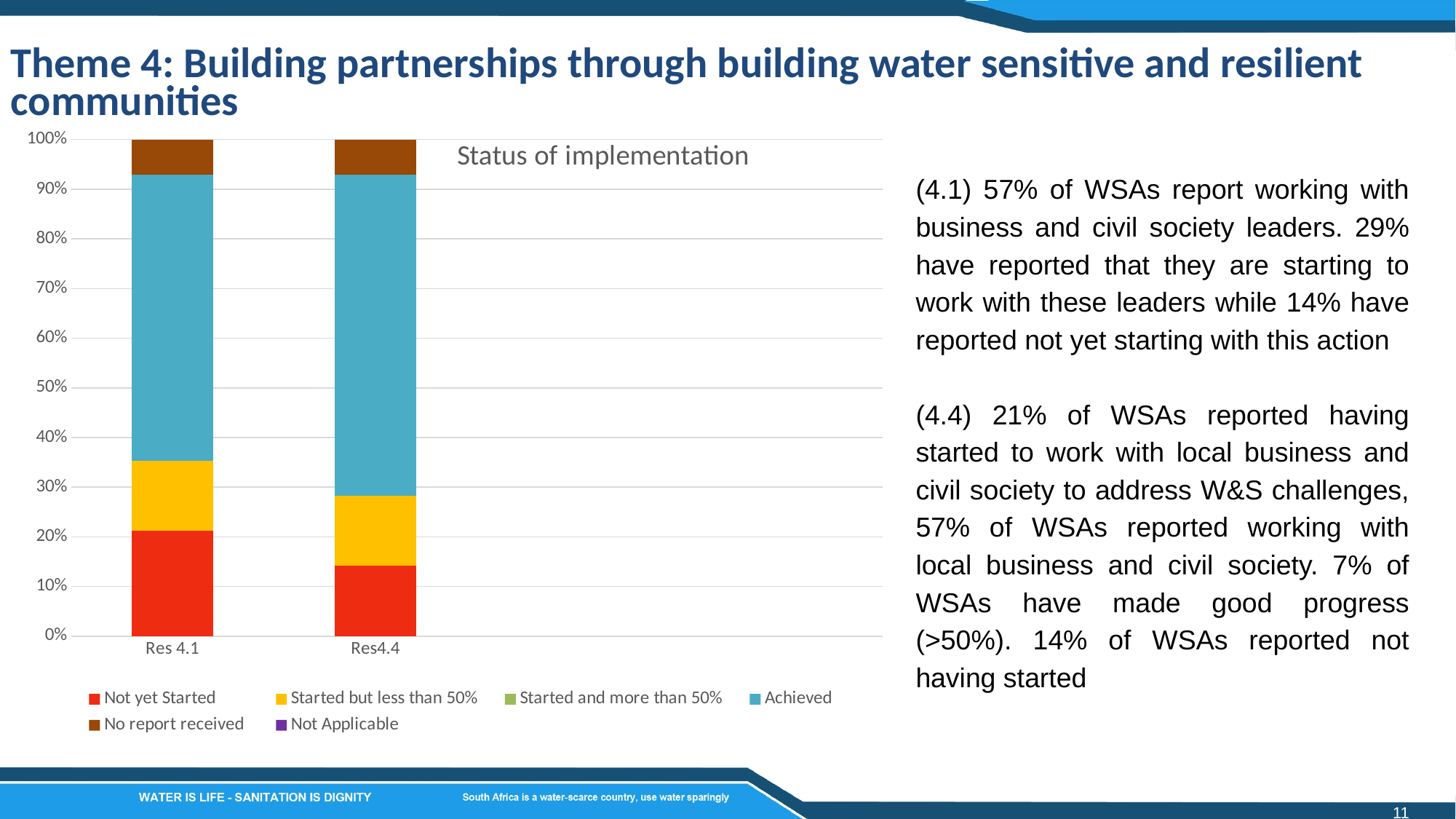
What colour represents the 'Achieved' series in the chart? Blue What kind of chart is shown on the slide? Stacked bar chart What is the title of the chart? Status of implementation Is the 'Not yet Started' value for Res 4.1 greater or less than 30%? less Is the top of the 'Achieved' segment for Res4.4 greater or less than 80%? greater Is the 'Not yet Started' value for Res4.4 greater or less than 20%? less How many series does the chart legend list? 6 Which category has the larger 'Not yet Started' segment, Res 4.1 or Res4.4? Res 4.1 How many categories are plotted on the x axis of the chart? 2 Which category has the larger 'Achieved' segment, Res 4.1 or Res4.4? Res4.4